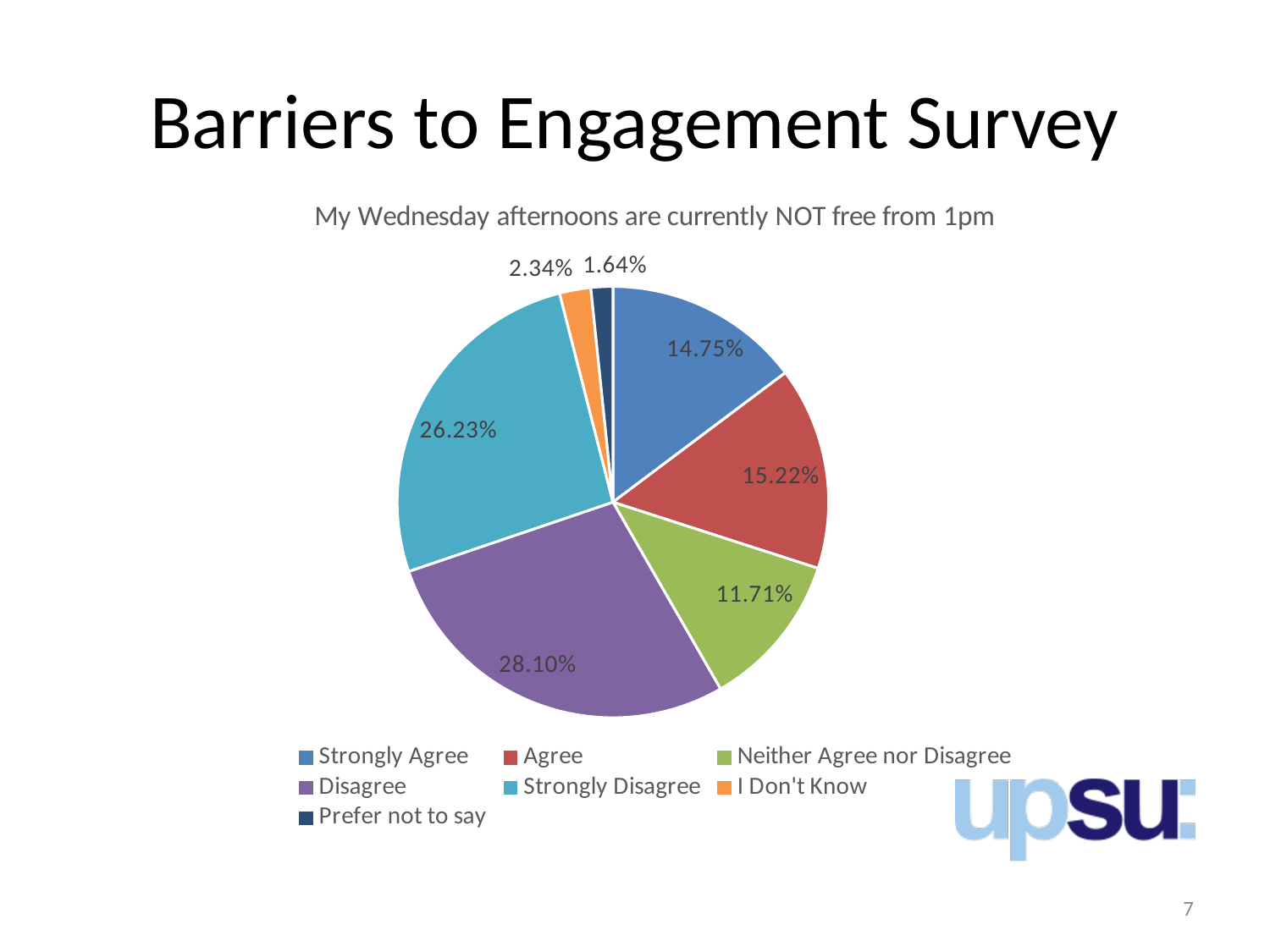
What percentage of respondents chose Disagree? 28.10% Which is larger, the share for Agree or the share for Neither Agree nor Disagree? Agree Which response has the smallest share of the pie? Prefer not to say What is the combined share of Disagree and Strongly Disagree? 54.33% How many response categories does the pie chart show? 7 What percentage of respondents chose I Don't Know? 2.34% Which response has the largest share of the pie? Disagree What percentage of respondents chose Neither Agree nor Disagree? 11.71% What percentage of respondents chose Strongly Agree? 14.75% What type of chart is shown on the slide? Pie chart What is the title of the chart? My Wednesday afternoons are currently NOT free from 1pm What is the difference in percentage points between Disagree and Strongly Disagree? 1.87